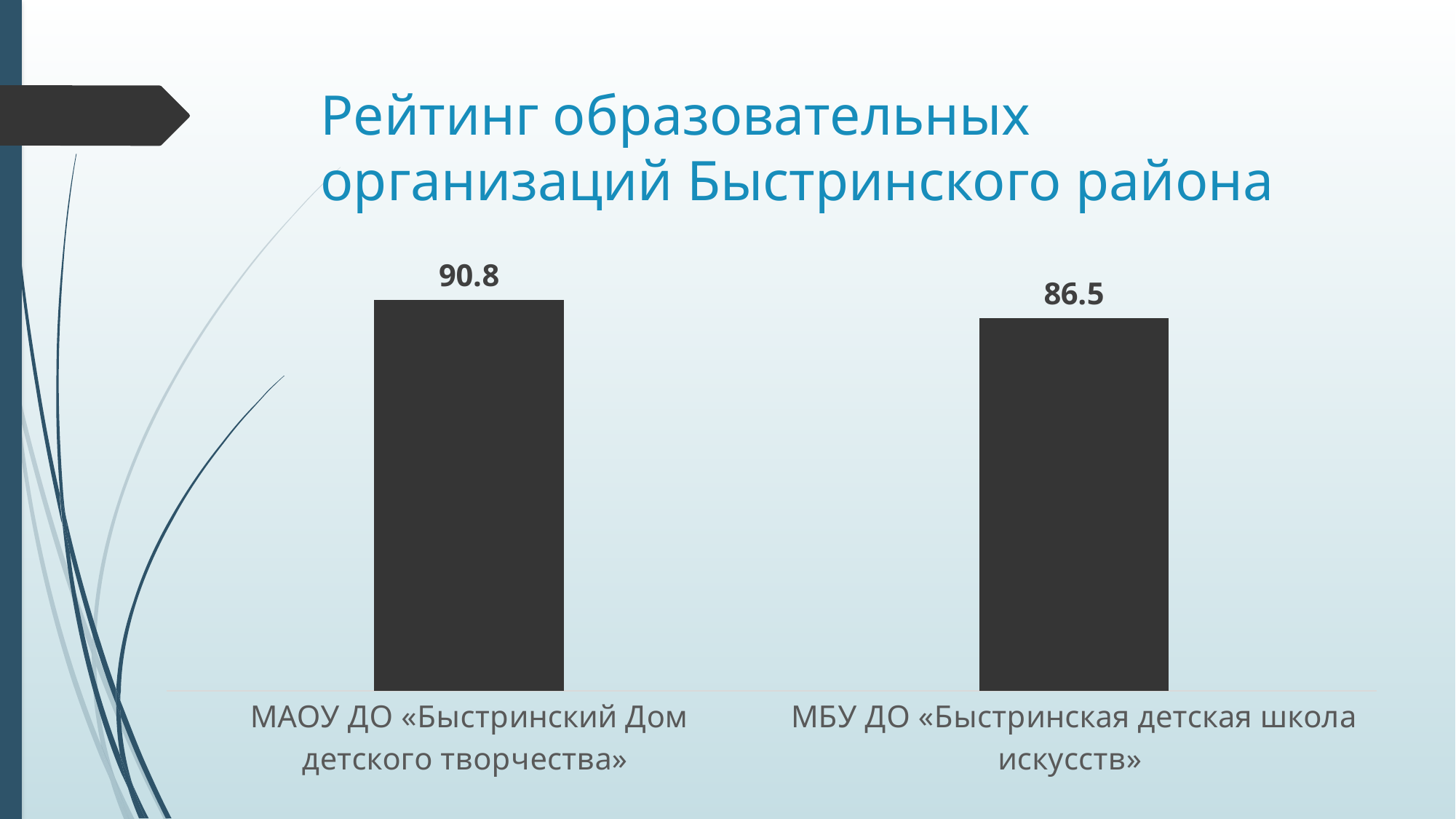
What is the value for МАОУ ДО «Быстринский Дом детского творчества»? 90.8 What is the value for МБУ ДО «Быстринская детская школа искусств»? 86.5 What is the difference between the values for МАОУ ДО «Быстринский Дом детского творчества» and МБУ ДО «Быстринская детская школа искусств»? 4.3 What kind of chart is shown on the slide? Bar chart Which organisation has the lowest value? МБУ ДО «Быстринская детская школа искусств» Do the values rise or fall from left to right across the chart? Fall What colour are the bars in the chart? Dark grey What is the title of the slide? Рейтинг образовательных организаций Быстринского района Which is larger: the value for МАОУ ДО «Быстринский Дом детского творчества» or for МБУ ДО «Быстринская детская школа искусств»? МАОУ ДО «Быстринский Дом детского творчества» Which organisation has the highest value? МАОУ ДО «Быстринский Дом детского творчества» How many organisations are shown in the chart? 2